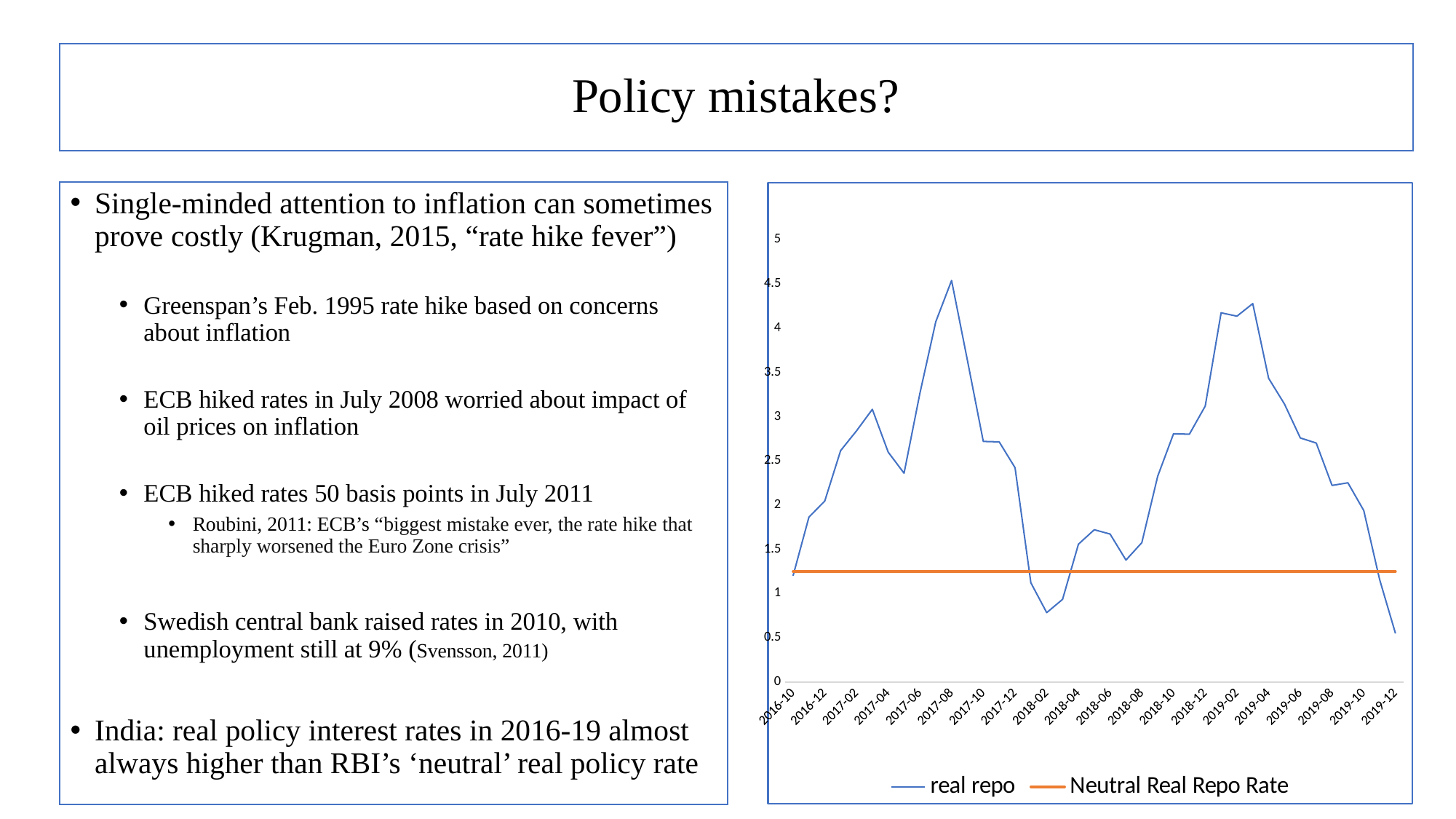
Does the real repo line rise or fall between 2017-05 and 2017-08? rise What are the two series named in the chart's legend? real repo; Neutral Real Repo Rate Is the real repo value at 2019-03 greater or less than 4? greater Is the real repo value at 2019-12 greater or less than 1? less Is the real repo value at 2018-02 greater or less than 1? less How many series does the chart's legend list? 2 What kind of chart is shown on the slide? line chart Which is larger, the real repo value at 2017-08 or at 2019-12? 2017-08 Does the real repo line rise or fall between 2019-04 and 2019-12? fall What colour is the Neutral Real Repo Rate line in the chart? orange